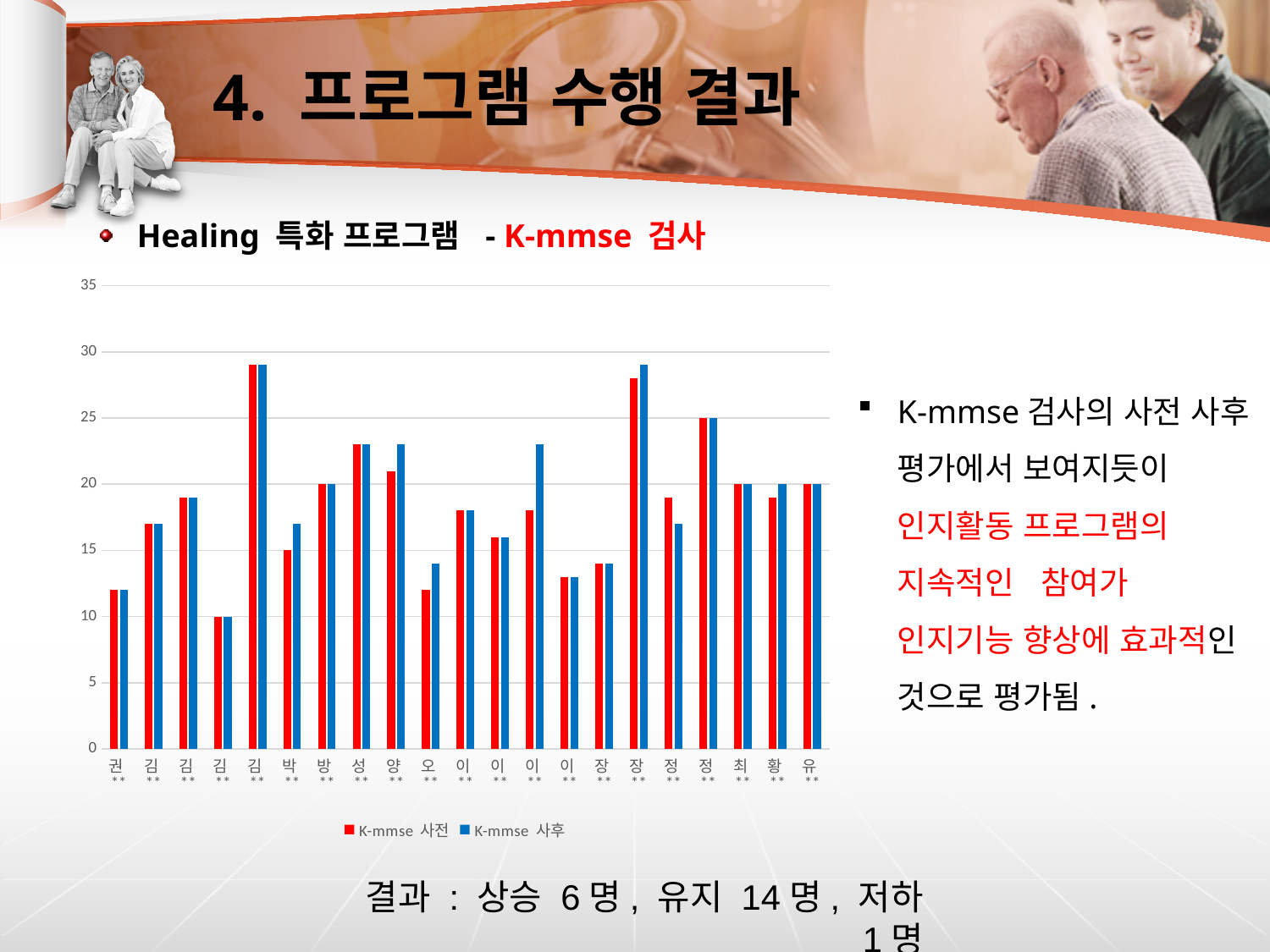
What is the K-mmse 사전 value for 유**? 20 Is the K-mmse 사전 value for 권** greater or less than 15? less What is the K-mmse 사후 value for 최**? 20 What kind of chart is shown on the slide? bar chart What is the K-mmse 사전 value for 방**? 20 How many series does the chart legend list? 2 Is the K-mmse 사후 value for 성** greater or less than 20? greater For 오**, which is larger: the K-mmse 사전 value or the K-mmse 사후 value? K-mmse 사후 Is the K-mmse 사후 value for 박** greater or less than 15? greater How many participants (categories) are shown on the x axis of the chart? 21 What are the two series named in the chart legend? K-mmse 사전, K-mmse 사후 Which colour represents the K-mmse 사전 series in the chart? red